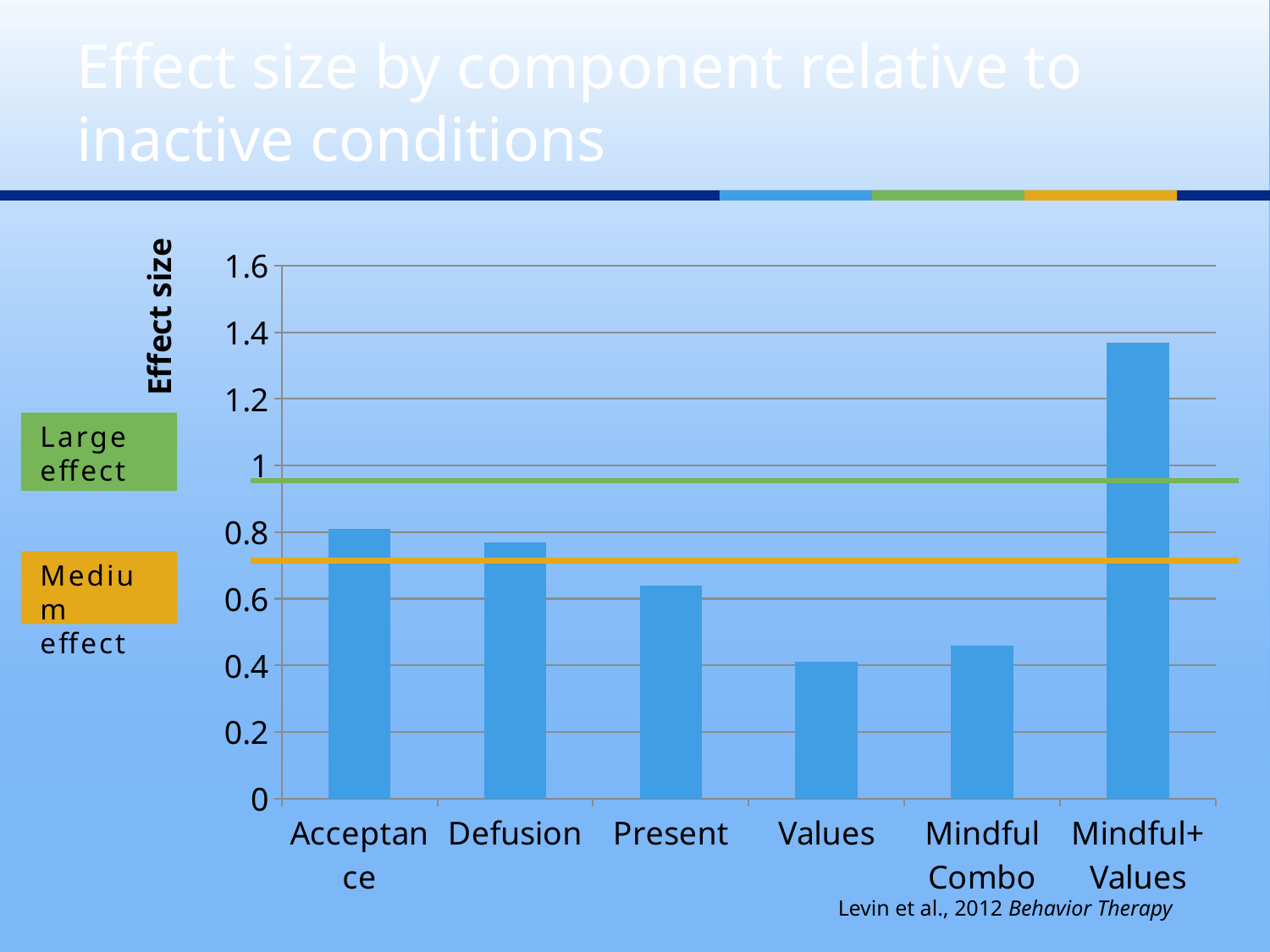
Which has a larger effect size, Present or Mindful Combo? Present Is the effect size for Defusion greater or less than 1? less Which has a larger effect size, Acceptance or Values? Acceptance Is the effect size for Values greater or less than 0.6? less How many components (categories) are plotted on the x axis? 6 What kind of chart is shown on the slide? bar chart Which component has the lowest effect size? Values Which component has the highest effect size? Mindful+Values Is the effect size for Mindful+Values greater or less than 1.2? greater What is the label of the vertical axis? Effect size